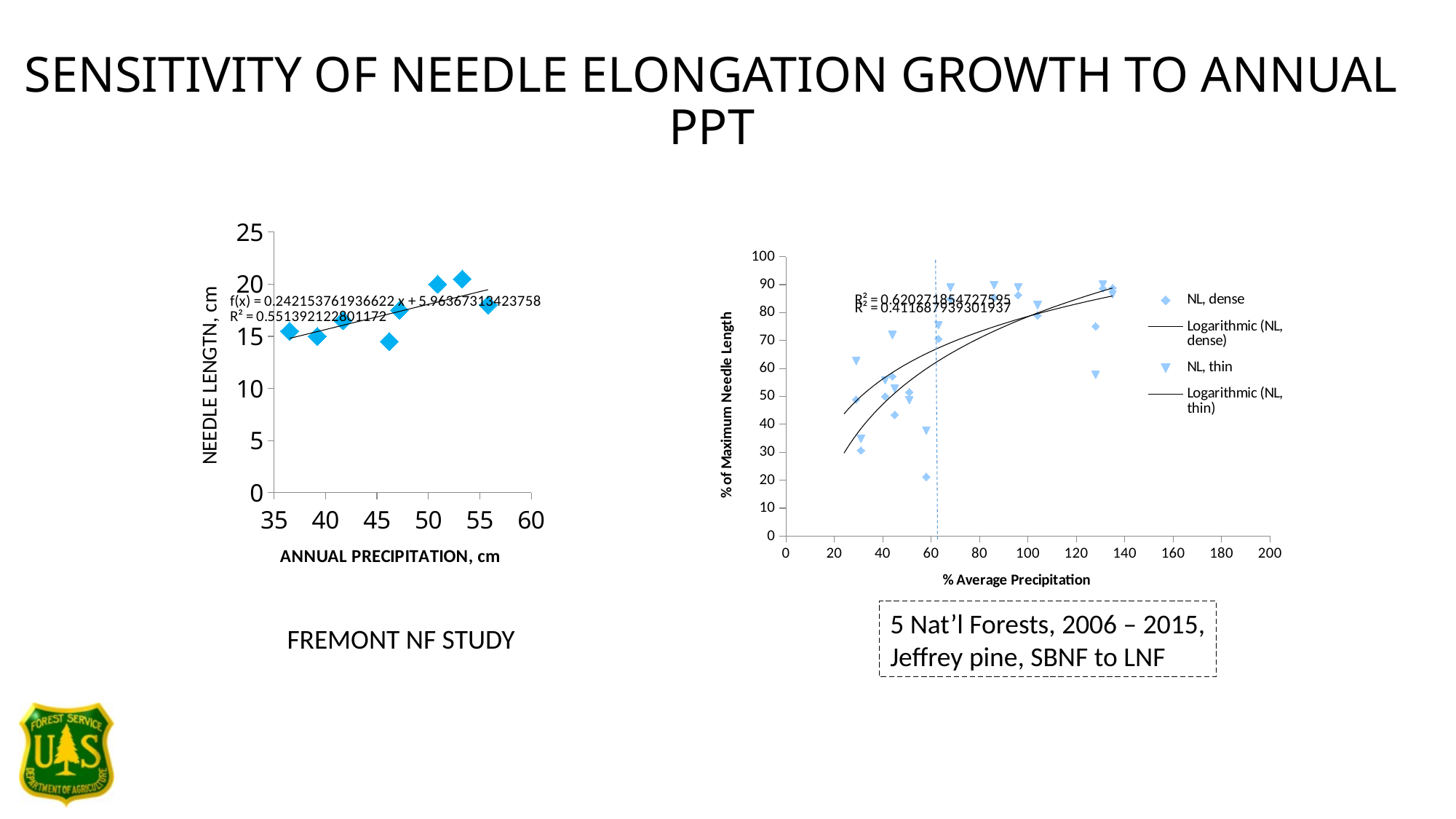
What is the x-axis label of the left chart? ANNUAL PRECIPITATION, cm What is the y-axis label of the right chart? % of Maximum Needle Length In the left chart, do needle length values generally rise or fall as annual precipitation increases? rise What kind of chart is the left chart (Fremont NF study)? scatter chart In the left chart, is the needle length at about 51 cm annual precipitation greater or less than 15? greater In the right chart, is the lowest NL, dense point greater or less than 30? less What is the highest tick value on the y-axis of the left chart? 25 What R² value is printed on the left chart? R² = 0.551392122801172 What is the highest tick value on the x-axis of the right chart? 200 How many entries does the legend of the right chart list? 4 What kind of chart is the right chart (% of Maximum Needle Length vs % Average Precipitation)? scatter chart In the right chart, do the fitted logarithmic curves rise or fall as % Average Precipitation increases? rise